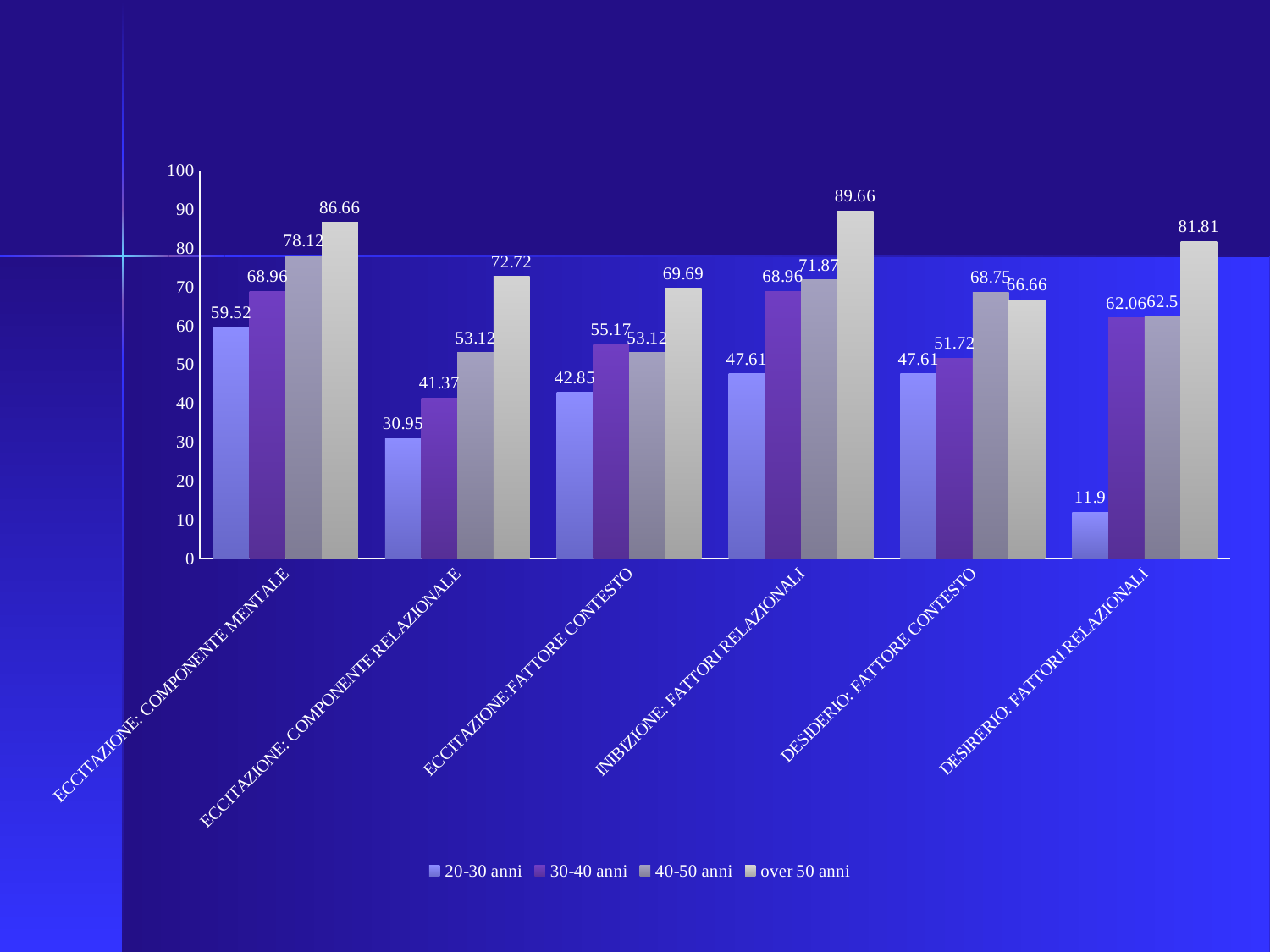
What is the value for the 30-40 anni series in the ECCITAZIONE: COMPONENTE RELAZIONALE category? 41.37 What is the value for the 20-30 anni series in the DESIRERIO: FATTORI RELAZIONALI category? 11.9 In the DESIDERIO: FATTORE CONTESTO category, which is larger: the 40-50 anni value or the over 50 anni value? 40-50 anni What is the value for the over 50 anni series in the INIBIZIONE: FATTORI RELAZIONALI category? 89.66 How many categories are shown on the x axis? 6 Which category has the highest value for the over 50 anni series? INIBIZIONE: FATTORI RELAZIONALI Which category has the lowest value for the 20-30 anni series? DESIRERIO: FATTORI RELAZIONALI What is the difference between the over 50 anni and 20-30 anni values in the ECCITAZIONE: COMPONENTE MENTALE category? 27.14 How many series does the legend list? 4 What kind of chart is shown on the slide? Bar chart What is the value for the 20-30 anni series in the ECCITAZIONE: COMPONENTE MENTALE category? 59.52 What is the last entry in the chart legend? over 50 anni